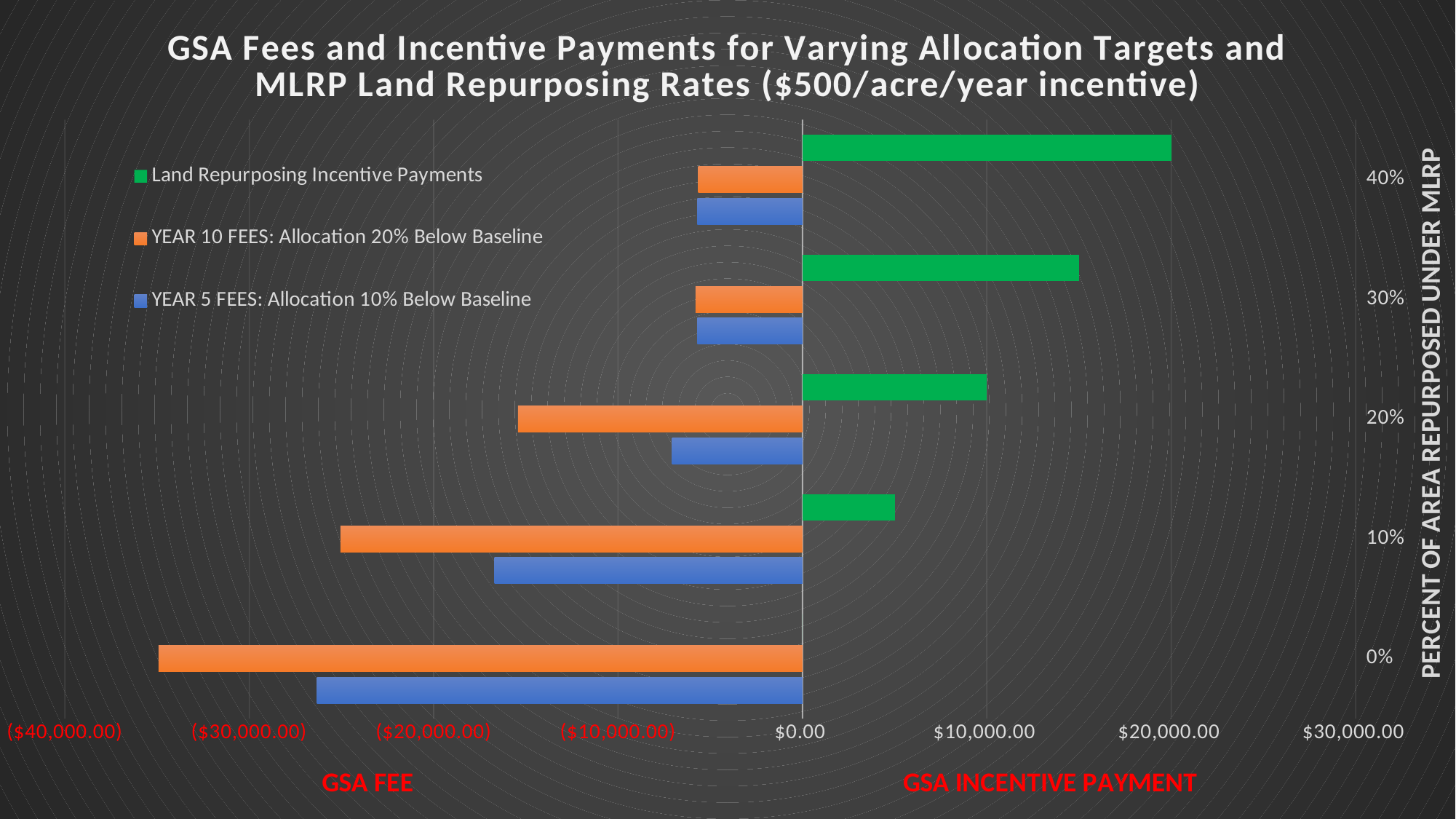
What is the Land Repurposing Incentive Payment at 20% of area repurposed under MLRP? $10,000.00 At 10% of area repurposed, which fee is larger in magnitude: YEAR 10 FEES or YEAR 5 FEES? YEAR 10 FEES What colour represents the YEAR 5 FEES: Allocation 10% Below Baseline series? blue Does the YEAR 10 FEES bar at 0% extend beyond ($30,000.00) on the axis? yes How many series does the legend list? 3 At which percent of area repurposed is the YEAR 10 FEES bar longest (largest fee)? 0% What is the Land Repurposing Incentive Payment at 40% of area repurposed under MLRP? $20,000.00 Is the YEAR 5 FEES value at 10% greater or less than ($20,000.00)? greater How many percent-of-area categories are plotted on the vertical axis? 5 Do the Land Repurposing Incentive Payments rise or fall as the percent of area repurposed increases? rise What kind of chart is shown on the slide? bar chart At which percent of area repurposed is the Land Repurposing Incentive Payment highest? 40%